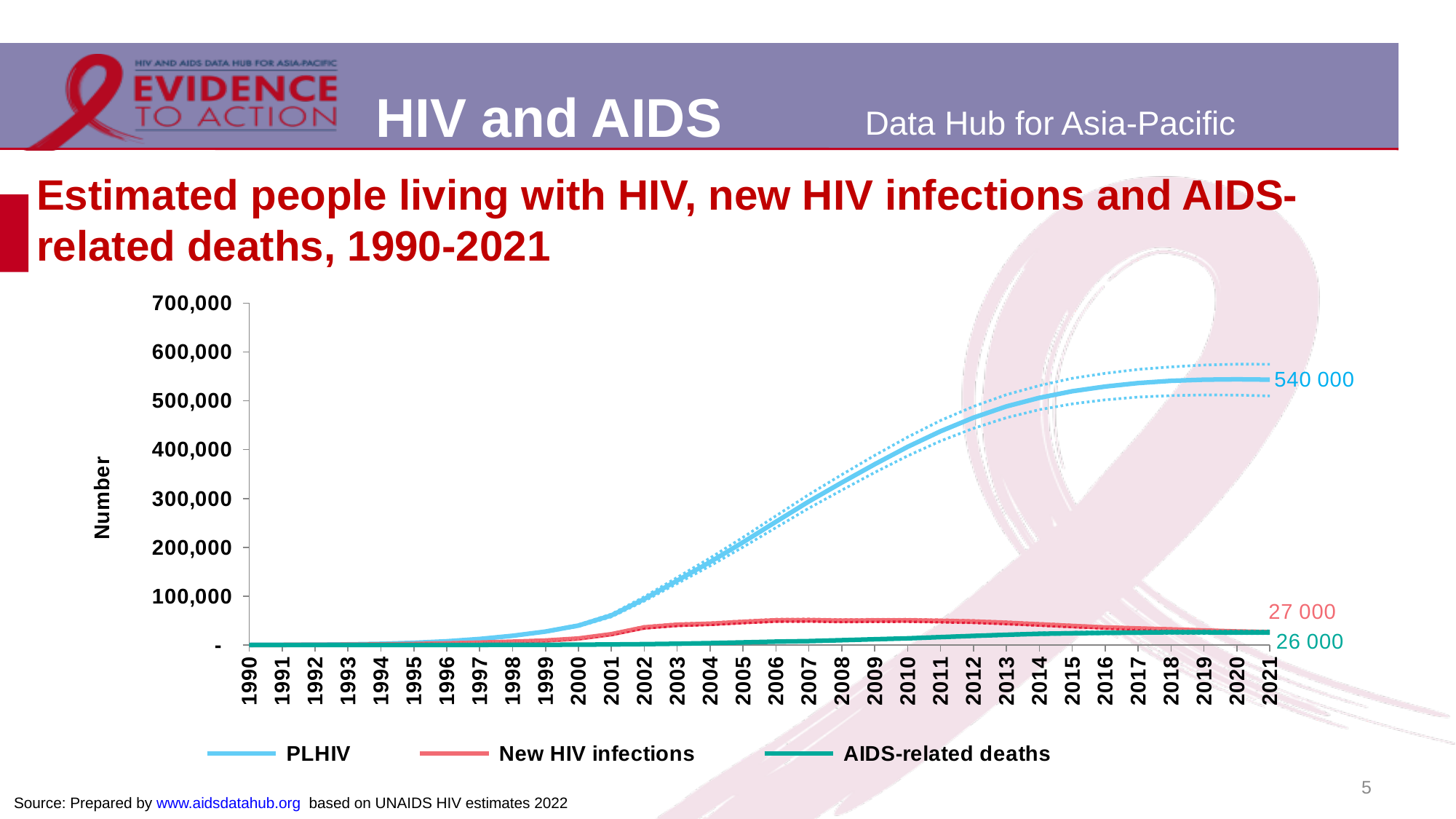
Is the value for PLHIV in 2000 greater or less than 100,000? less What kind of chart is this? Line chart What is the value for PLHIV in 2021? 540 000 How many years are shown on the x axis? 32 How many series does the legend list? 3 Does the PLHIV line rise or fall from 1990 to 2021? Rise What is the difference between the PLHIV value and the New HIV infections value in 2021? 513 000 Which series has the lowest value in 2021? AIDS-related deaths Which series has the highest value in 2021? PLHIV What is the value for AIDS-related deaths in 2021? 26 000 What is the value for New HIV infections in 2021? 27 000 Is the value for PLHIV in 2021 greater or less than 500,000? greater